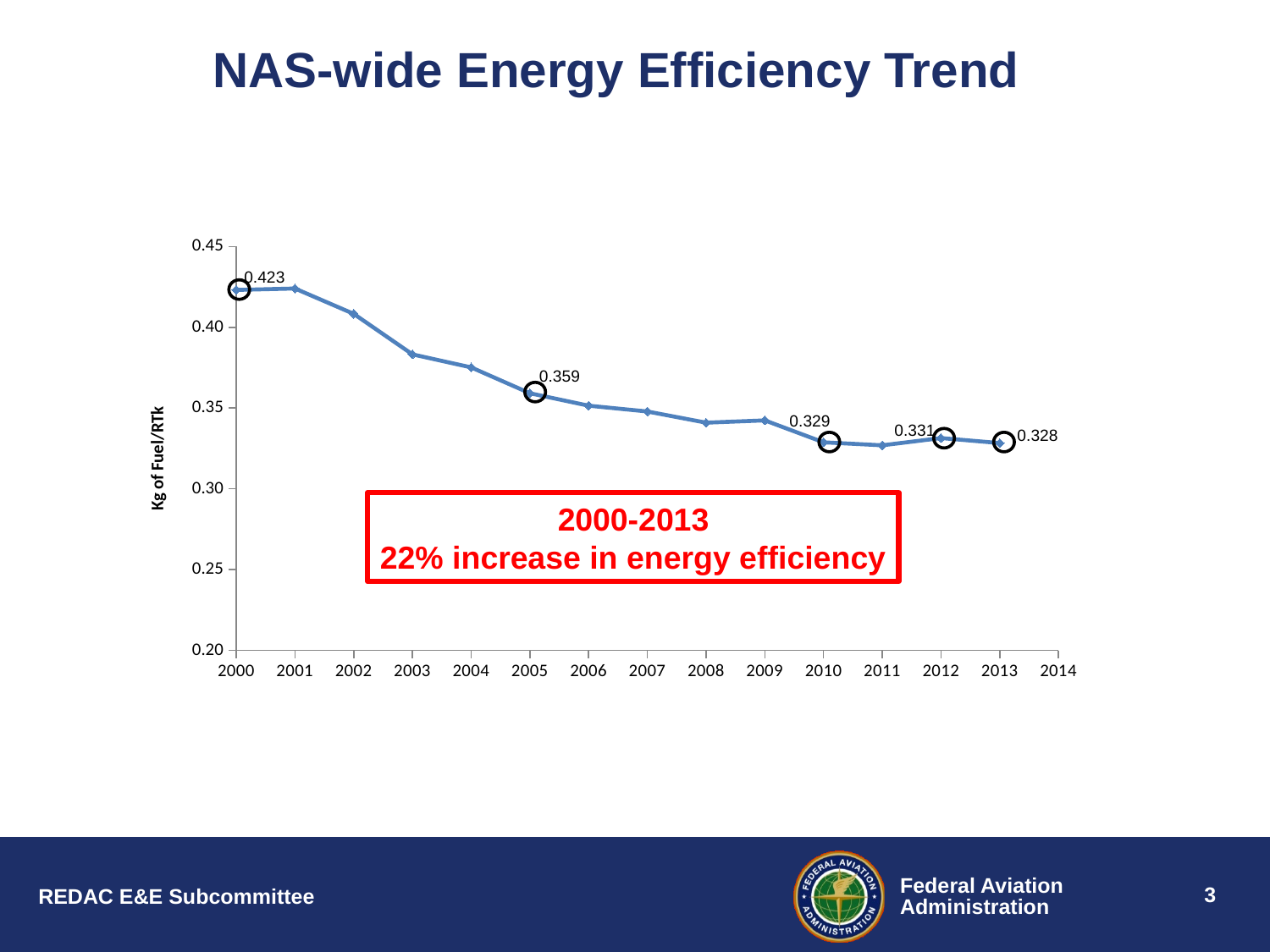
What is the value for 2005? 0.359 Which year has the larger value, 2010 or 2012? 2012 What kind of chart is shown on the slide? line chart What is the value for 2013? 0.328 What is the difference between the values for 2000 and 2013? 0.095 Is the value for 2008 greater or less than 0.35? less What is the value for 2000? 0.423 What is the difference between the values for 2005 and 2010? 0.030 How many data points are plotted on the line? 14 What is the value for 2010? 0.329 Do the values rise or fall from 2000 to 2013? fall Is the value for 2003 greater or less than 0.40? less